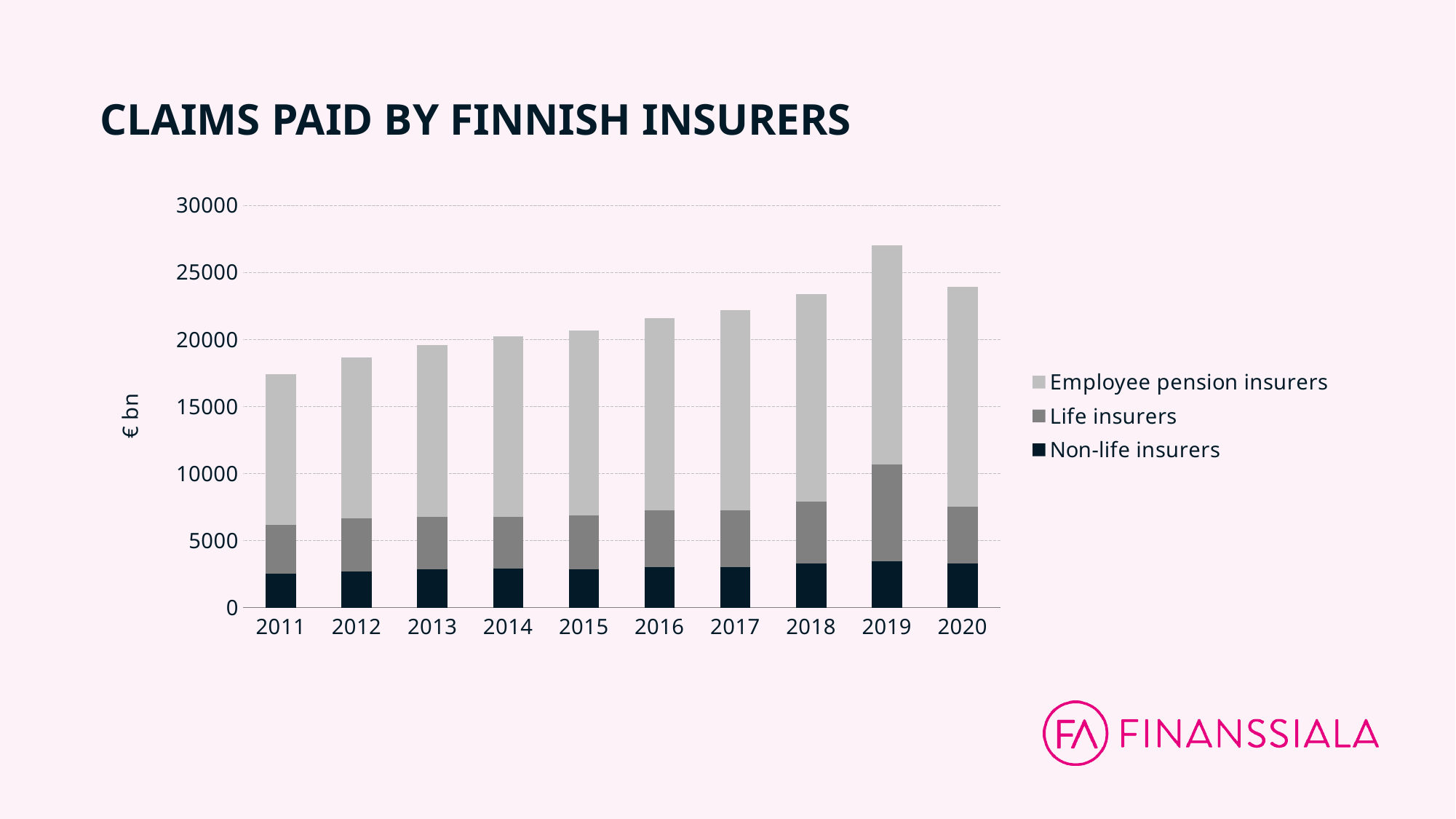
Is the total claims paid in 2011 greater or less than 20000? less Which year has the lowest total claims paid? 2011 Is the total claims paid in 2018 greater or less than 20000? greater Which year has the highest total claims paid? 2019 Do total claims paid generally rise or fall from 2011 to 2019? rise How many years are shown on the x axis of the chart? 10 What kind of chart is shown on the slide? Stacked bar chart Is the total claims paid in 2020 greater or less than 25000? less How many series does the legend list? 3 Which is larger, the total claims paid in 2019 or in 2020? 2019 What is the unit shown on the y axis label? € bn